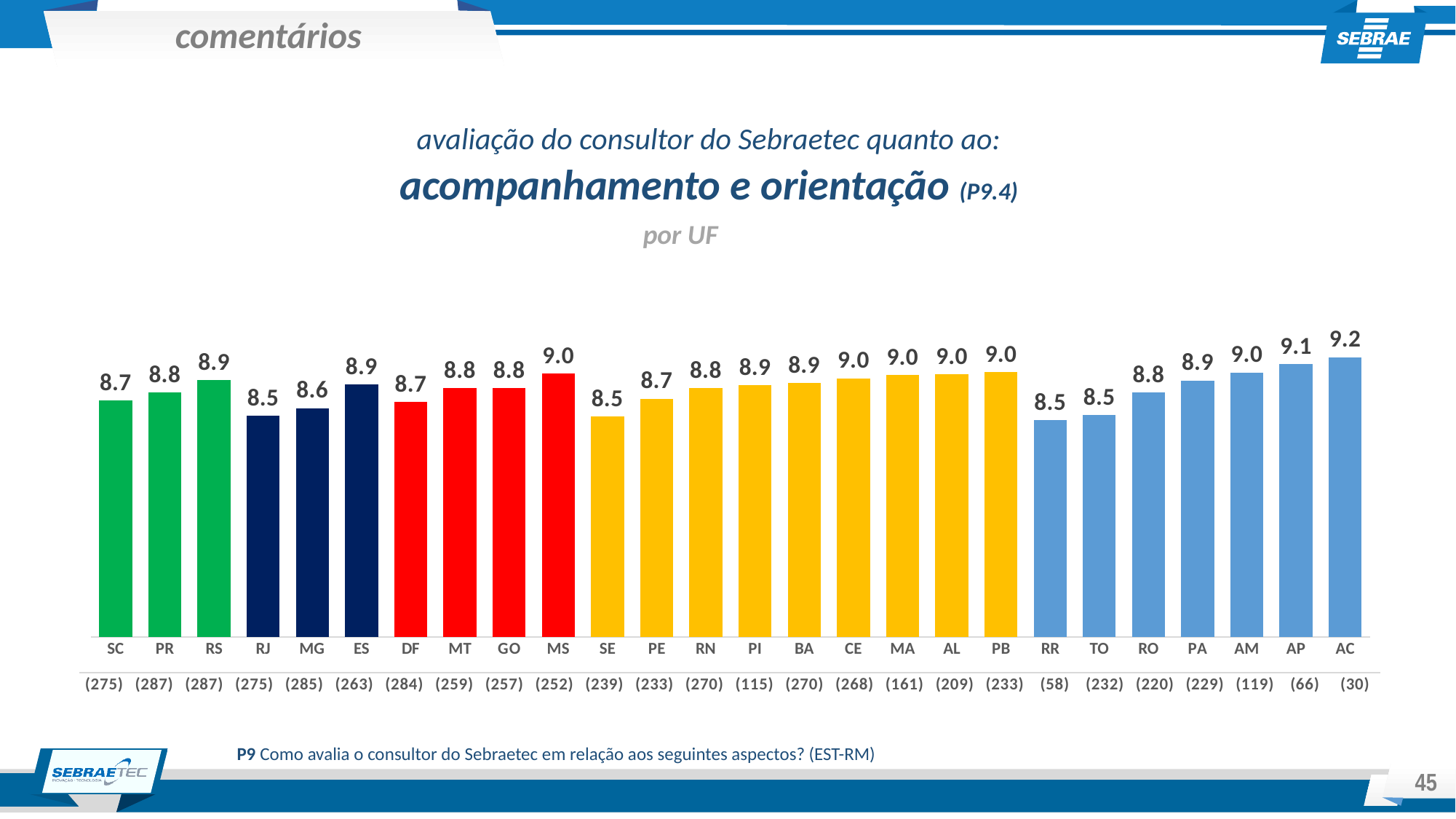
What is the value for PI? 8.9 What is the value for AC? 9.2 What is the lowest value shown on the chart? 8.5 What number is shown in parentheses below the AC bar? (30) What is the difference between the values for MS and SE? 0.5 What kind of chart is shown on the slide? Bar chart What is the difference between the values for AC and RJ? 0.7 How many UFs (bars) are shown on the chart? 26 What is the value for TO? 8.5 Which UF has the highest value? AC What is the value for MG? 8.6 Which is larger, the value for AP or the value for RR? AP